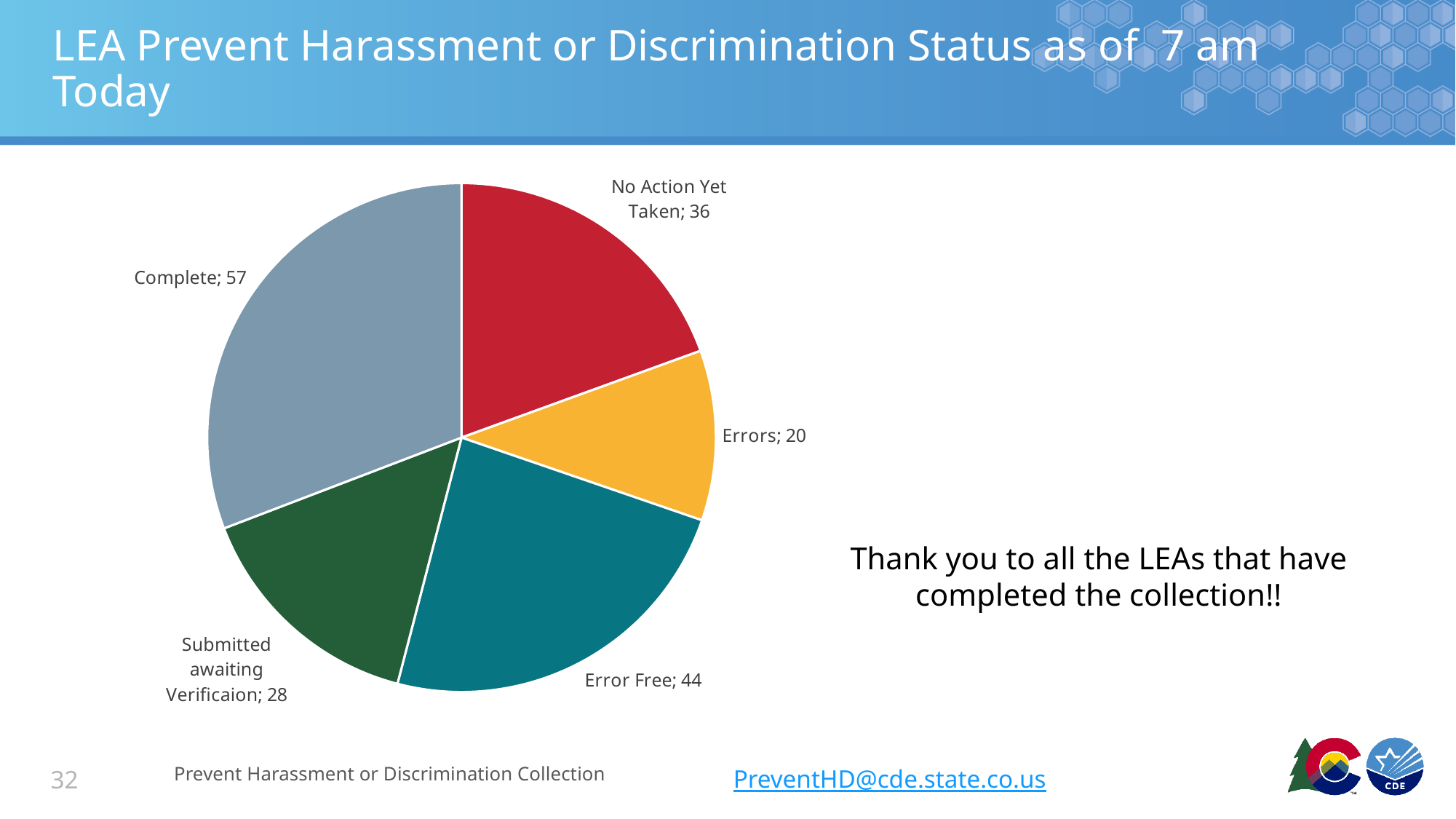
What is the value for Errors? 20 What is the total of all the slices in the pie chart? 185 Which category has the smallest slice? Errors What is the value for Submitted awaiting Verificaion? 28 What kind of chart is shown on the slide? pie chart What colour is the Error Free slice? teal What is the value for Complete? 57 What is the difference between the Complete value and the No Action Yet Taken value? 21 Which is larger, Error Free or Submitted awaiting Verificaion? Error Free How many slices does the pie chart have? 5 Which category has the largest slice? Complete What is the value for Error Free? 44